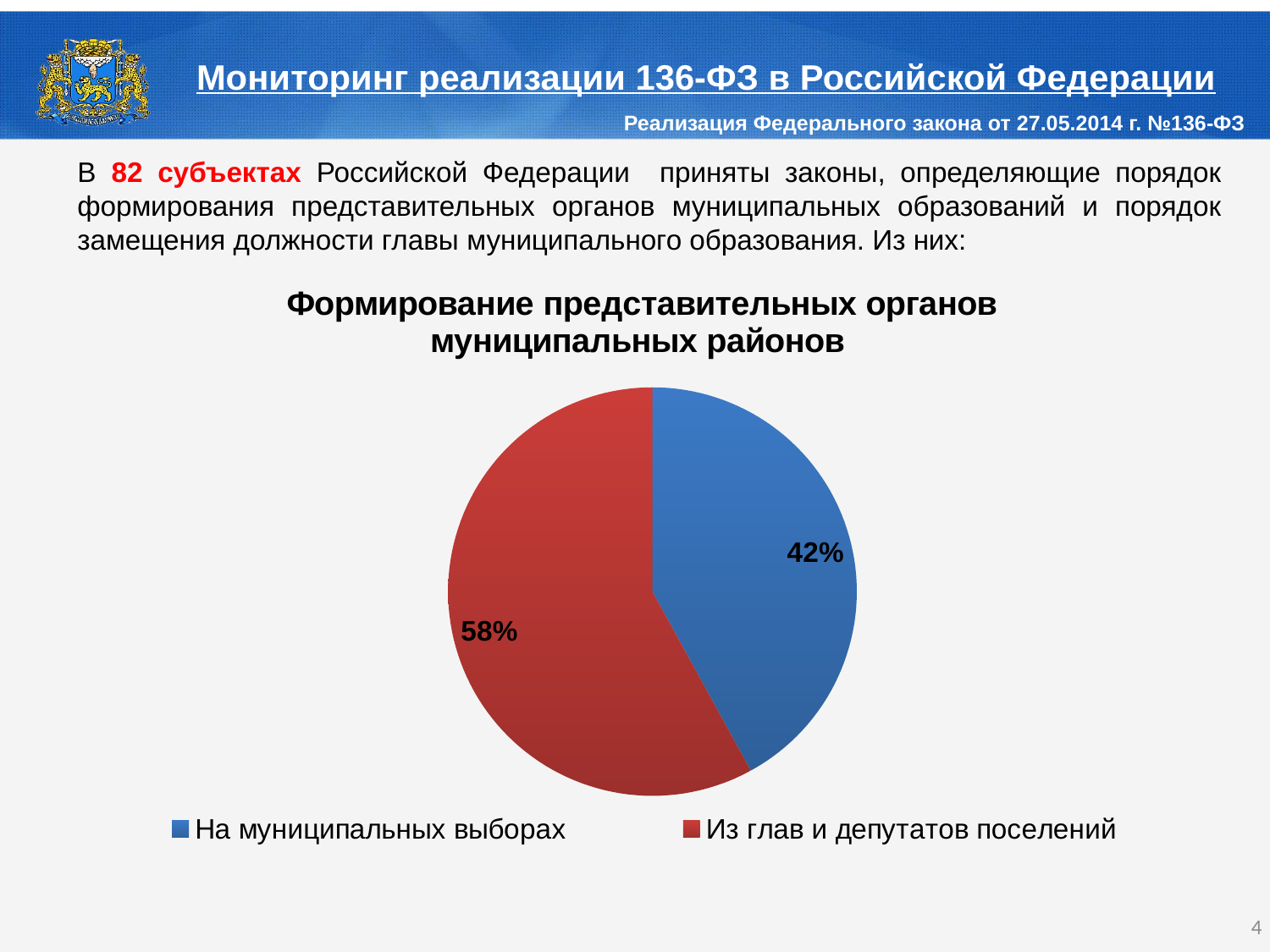
How many entries does the legend list? 2 Which is larger: the share for 'На муниципальных выборах' or for 'Из глав и депутатов поселений'? Из глав и депутатов поселений What kind of chart is shown on the slide? Pie chart Which category has the smallest share of the pie? На муниципальных выборах What is the value for 'На муниципальных выборах'? 42% What colour is the slice for 'Из глав и депутатов поселений'? Red Which category has the largest share of the pie? Из глав и депутатов поселений What is the difference between the shares for 'Из глав и депутатов поселений' and 'На муниципальных выборах'? 16% What is the title of the chart? Формирование представительных органов муниципальных районов What share of the pie does 'На муниципальных выборах' represent? 42% What is the value for 'Из глав и депутатов поселений'? 58% How many slices does the pie chart have? 2